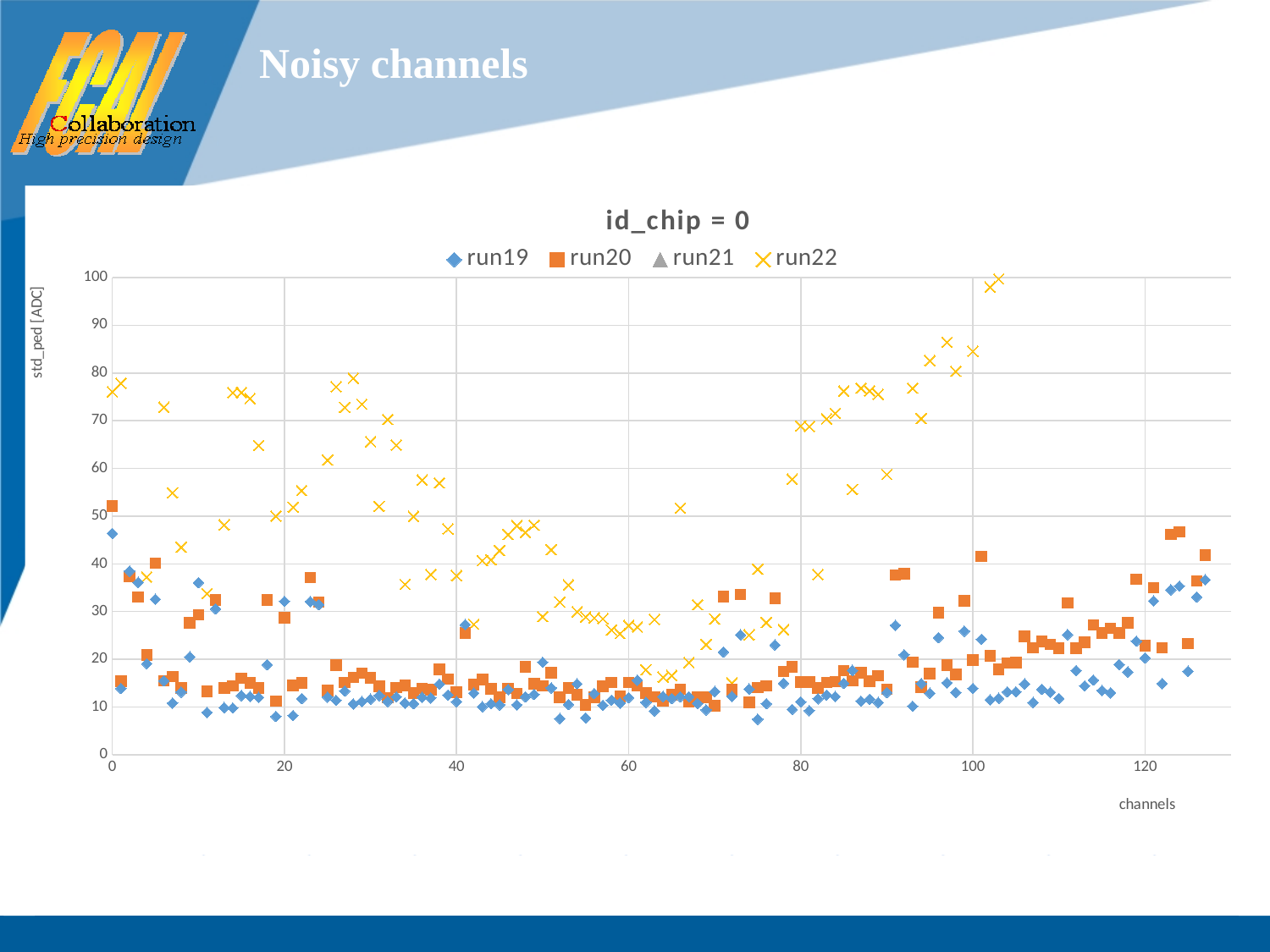
How many series does the legend of the chart list? 4 Is the highest run22 value on the chart greater or less than 90? greater What kind of chart is shown on the slide? scatter chart What is the label of the vertical axis of the chart? std_ped [ADC] Which series reaches the highest std_ped value on the chart? run22 What is the title of the chart? id_chip = 0 Is the run19 value at channel 20 greater or less than 20? greater Is the run22 value at channel 1 greater or less than 70? greater Which series is plotted with x-shaped markers in the legend? run22 Around channel 100, which series has larger values: run22 or run19? run22